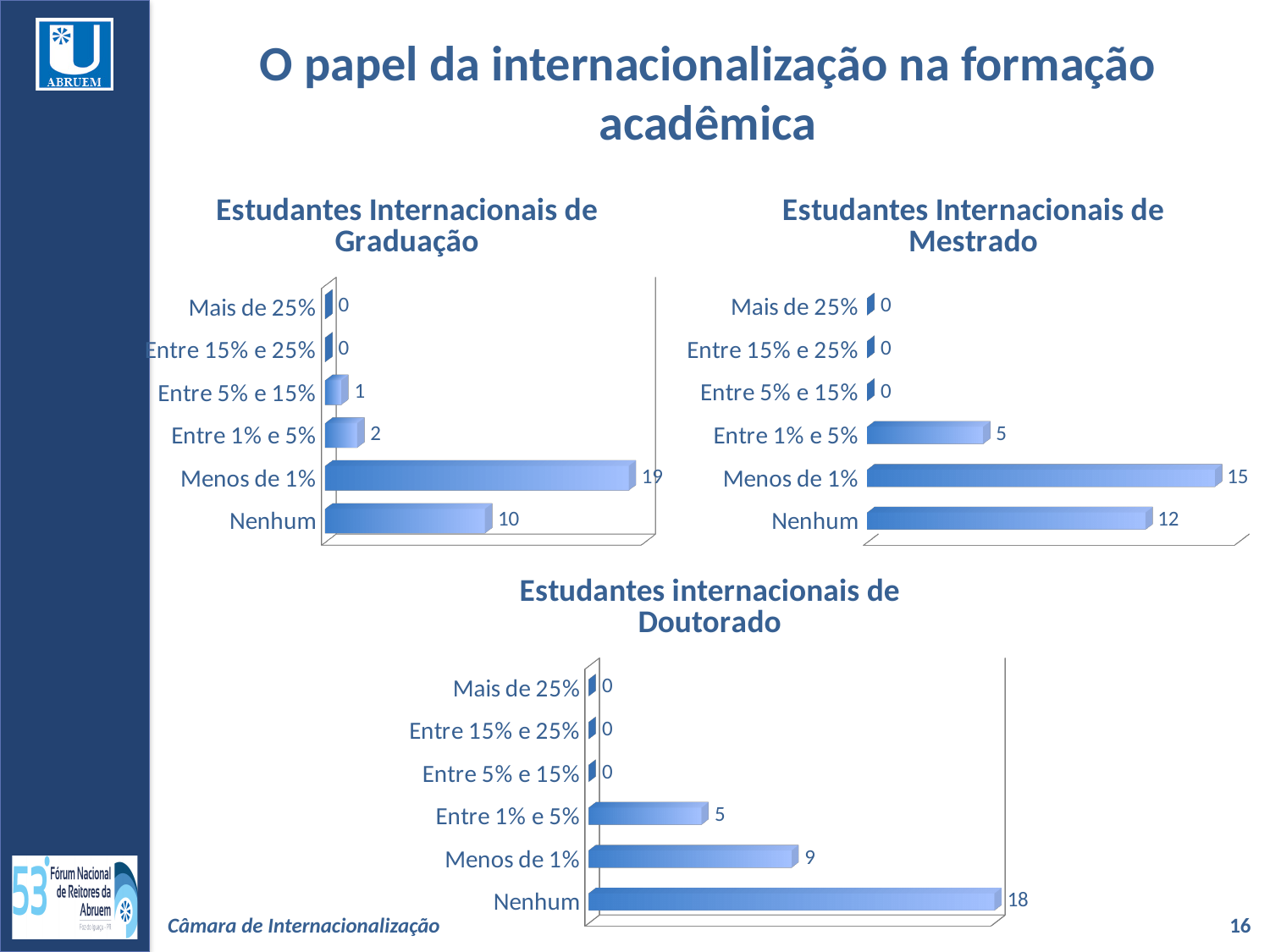
In the 'Estudantes internacionais de Doutorado' chart, which category has the highest value? Nenhum How many categories are shown in the 'Estudantes Internacionais de Graduação' chart? 6 In the 'Estudantes Internacionais de Mestrado' chart, what is the value for 'Entre 1% e 5%'? 5 In the 'Estudantes internacionais de Doutorado' chart, what is the value for 'Nenhum'? 18 In the 'Estudantes Internacionais de Graduação' chart, what is the value for 'Menos de 1%'? 19 What kind of chart is the 'Estudantes Internacionais de Mestrado' chart? Bar chart How many charts are shown on the slide? 3 In the 'Estudantes Internacionais de Mestrado' chart, what is the difference between the values for 'Menos de 1%' and 'Nenhum'? 3 In the 'Estudantes Internacionais de Graduação' chart, what is the difference between the values for 'Menos de 1%' and 'Nenhum'? 9 In the 'Estudantes Internacionais de Mestrado' chart, which category has the highest value? Menos de 1% In the 'Estudantes internacionais de Doutorado' chart, which is larger: the value for 'Menos de 1%' or the value for 'Entre 1% e 5%'? Menos de 1% In the 'Estudantes Internacionais de Graduação' chart, what is the value for 'Nenhum'? 10